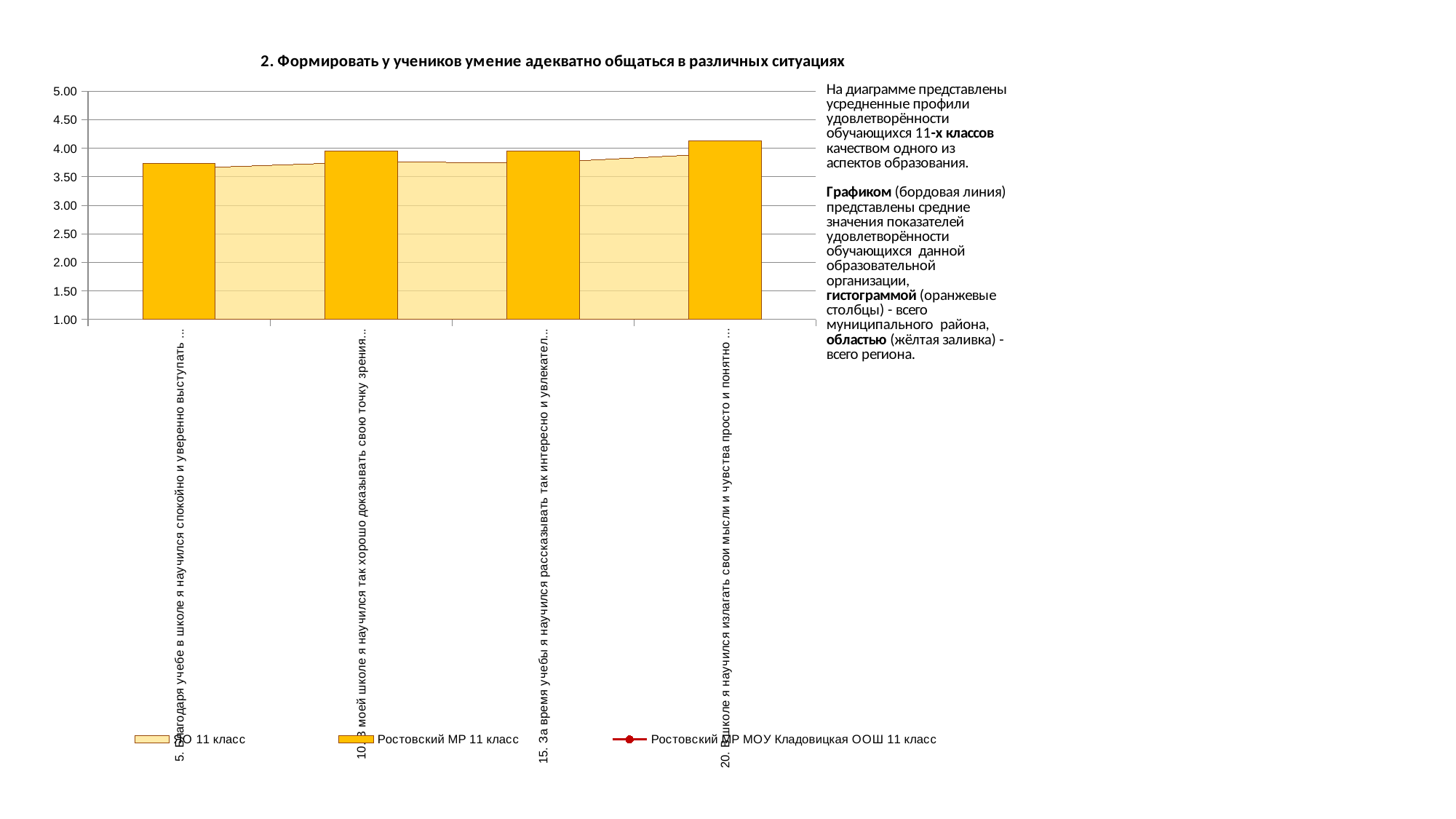
Is the Ростовский МР 11 класс value for category 5 greater or less than 3.50? greater Is the ЯО 11 класс value for category 10 greater or less than 4.00? less Which category has the lowest orange bar (Ростовский МР 11 класс)? 5. Благодаря учебе в школе я научился спокойно и уверенно выступать Which series is shown with yellow fill according to the legend? ЯО 11 класс How many categories are shown on the x axis? 4 What is the title of the chart? 2. Формировать у учеников умение адекватно общаться в различных ситуациях Which is larger for Ростовский МР 11 класс: the value for category 5 or the value for category 20? category 20 Which category has the highest orange bar (Ростовский МР 11 класс)? 20. В школе я научился излагать свои мысли и чувства просто и понятно How many series does the legend list? 3 Is the Ростовский МР 11 класс value for category 5 greater or less than 4.00? less Do the orange bars (Ростовский МР 11 класс) generally rise or fall from left to right? rise